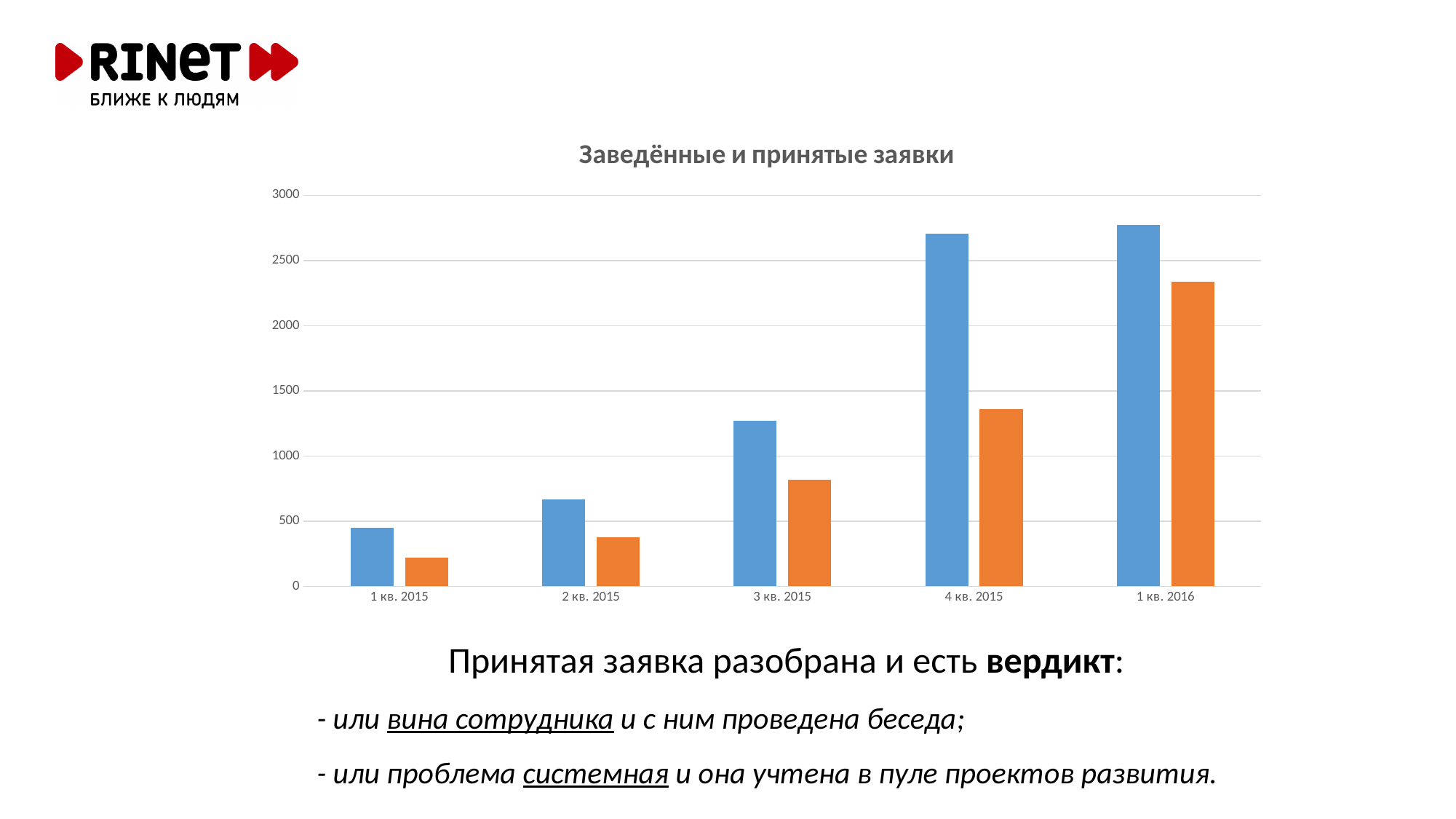
Is the orange bar for 3 кв. 2015 greater or less than 1000? less Which quarter has the shortest blue bar? 1 кв. 2015 Which quarter has the shortest orange bar? 1 кв. 2015 Which quarter has the tallest blue bar? 1 кв. 2016 What kind of chart is shown on the slide? bar chart Is the orange bar for 1 кв. 2016 greater or less than 2500? less In 4 кв. 2015, which bar is taller, the blue one or the orange one? the blue one How many quarters are shown on the x axis of the chart? 5 Is the blue bar for 2 кв. 2015 greater or less than 500? greater Which quarter has the tallest orange bar? 1 кв. 2016 What is the title of the chart? Заведённые и принятые заявки Do the blue bars rise or fall from 1 кв. 2015 to 1 кв. 2016? rise